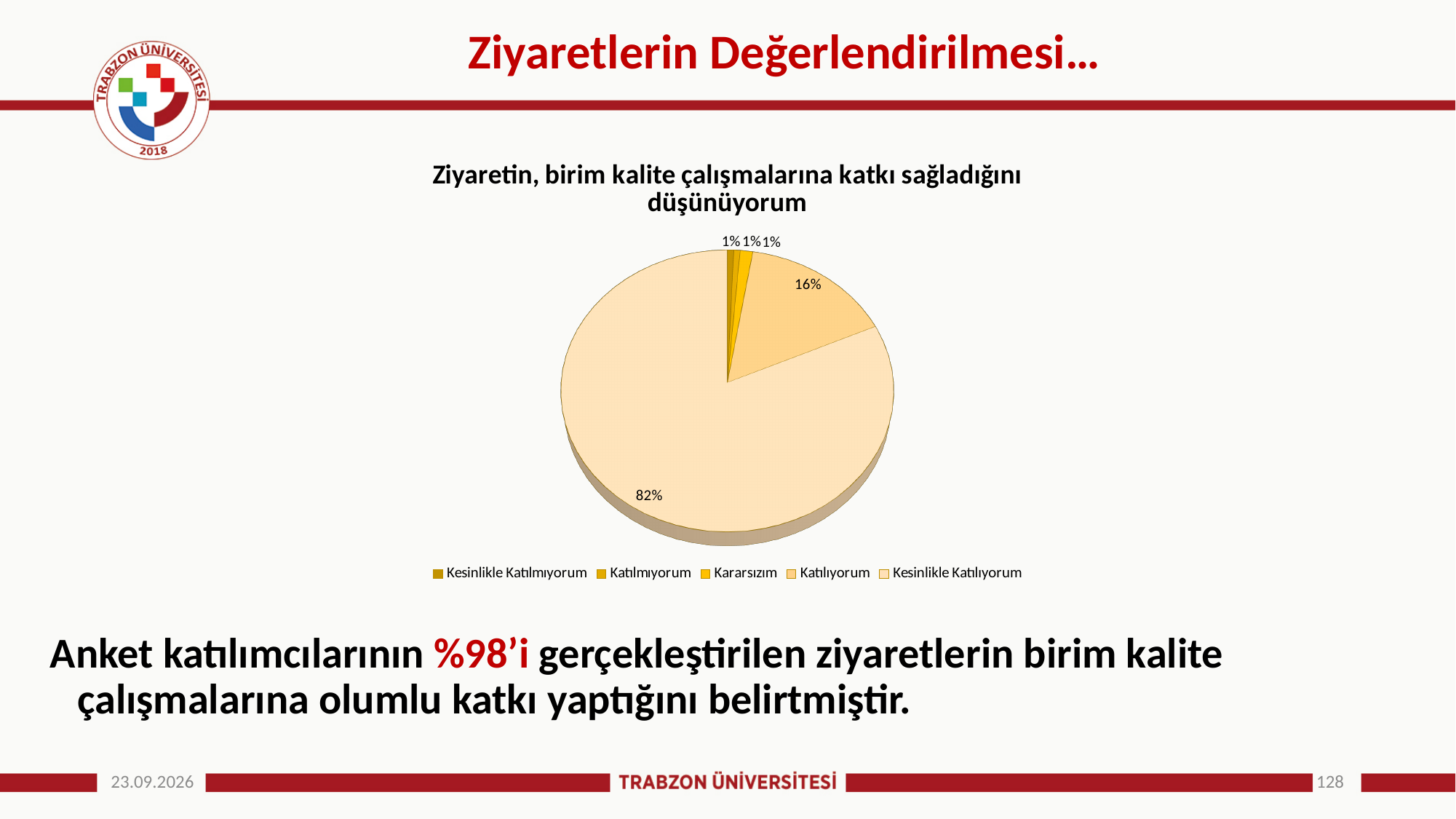
What is the title of the chart? Ziyaretin, birim kalite çalışmalarına katkı sağladığını düşünüyorum What is the combined share of the Katılıyorum and Kesinlikle Katılıyorum slices? 98% What share of the pie does the Kesinlikle Katılıyorum slice represent? 82% What kind of chart is shown on the slide? Pie chart Which category has the largest slice of the pie? Kesinlikle Katılıyorum What is the value shown for Katılıyorum? 16% How many categories does the pie chart have? 5 Which is larger, the Katılıyorum slice or the Kesinlikle Katılıyorum slice? Kesinlikle Katılıyorum What is the value shown for Kararsızım? 1% Which is larger, the Katılıyorum slice or the Kararsızım slice? Katılıyorum What is the difference in percentage points between the Kesinlikle Katılıyorum and Katılıyorum slices? 66 How many entries does the legend list? 5